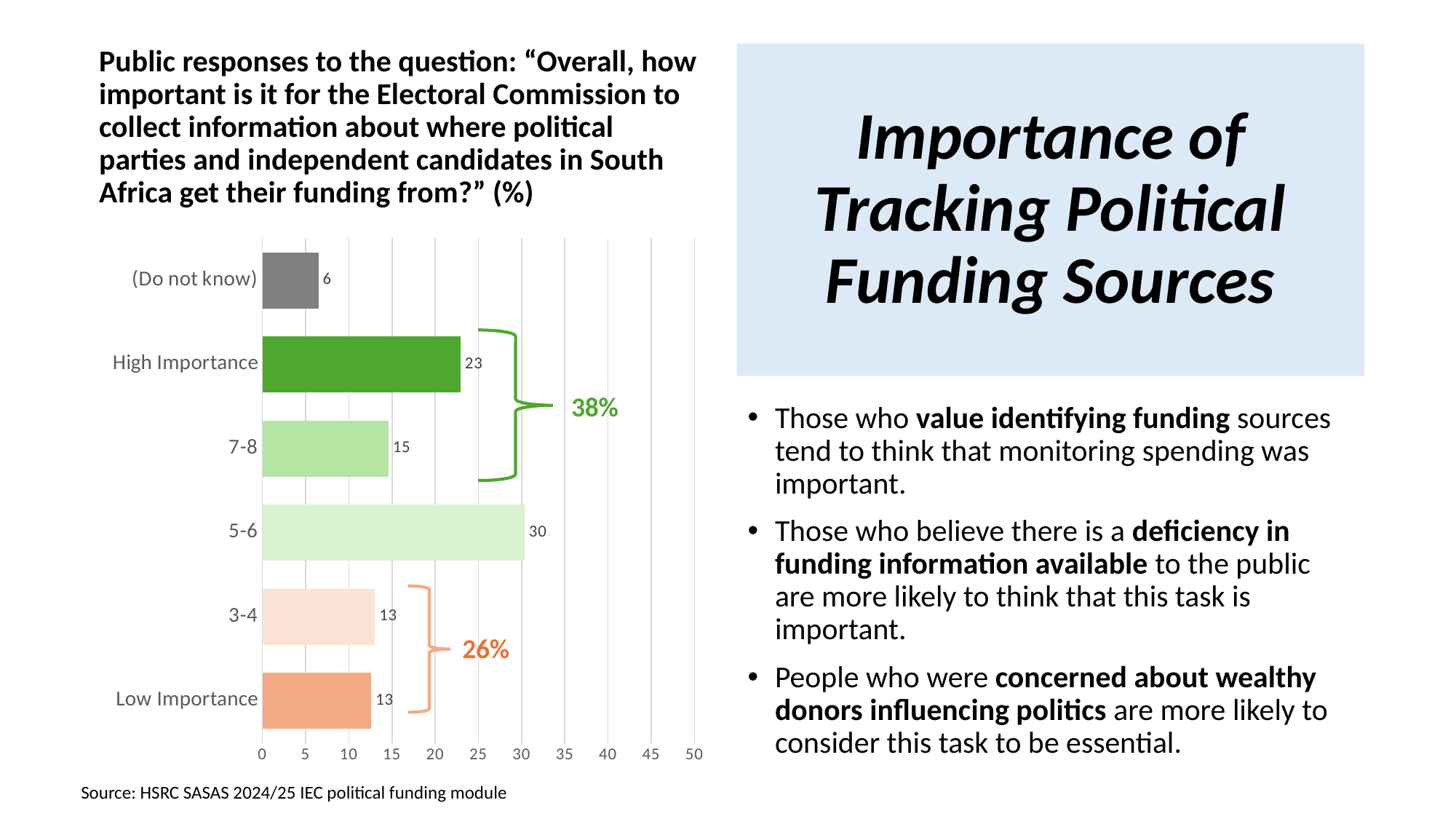
Which category has the lowest value? (Do not know) What combined percentage is shown by the orange bracket grouping '3-4' and 'Low Importance'? 26% What is the difference between the values for '5-6' and 'High Importance'? 7 What kind of chart is shown on the slide? Bar chart What value is shown for the '5-6' category? 30 Which is larger, the value for 'High Importance' or the value for '7-8'? High Importance Which category has the highest value? 5-6 What value is shown for the 'High Importance' category? 23 What combined percentage is shown by the green bracket grouping 'High Importance' and '7-8'? 38% How many categories are shown on the chart? 6 Is the value for '5-6' greater or less than 25? greater What value is shown for the '(Do not know)' category? 6